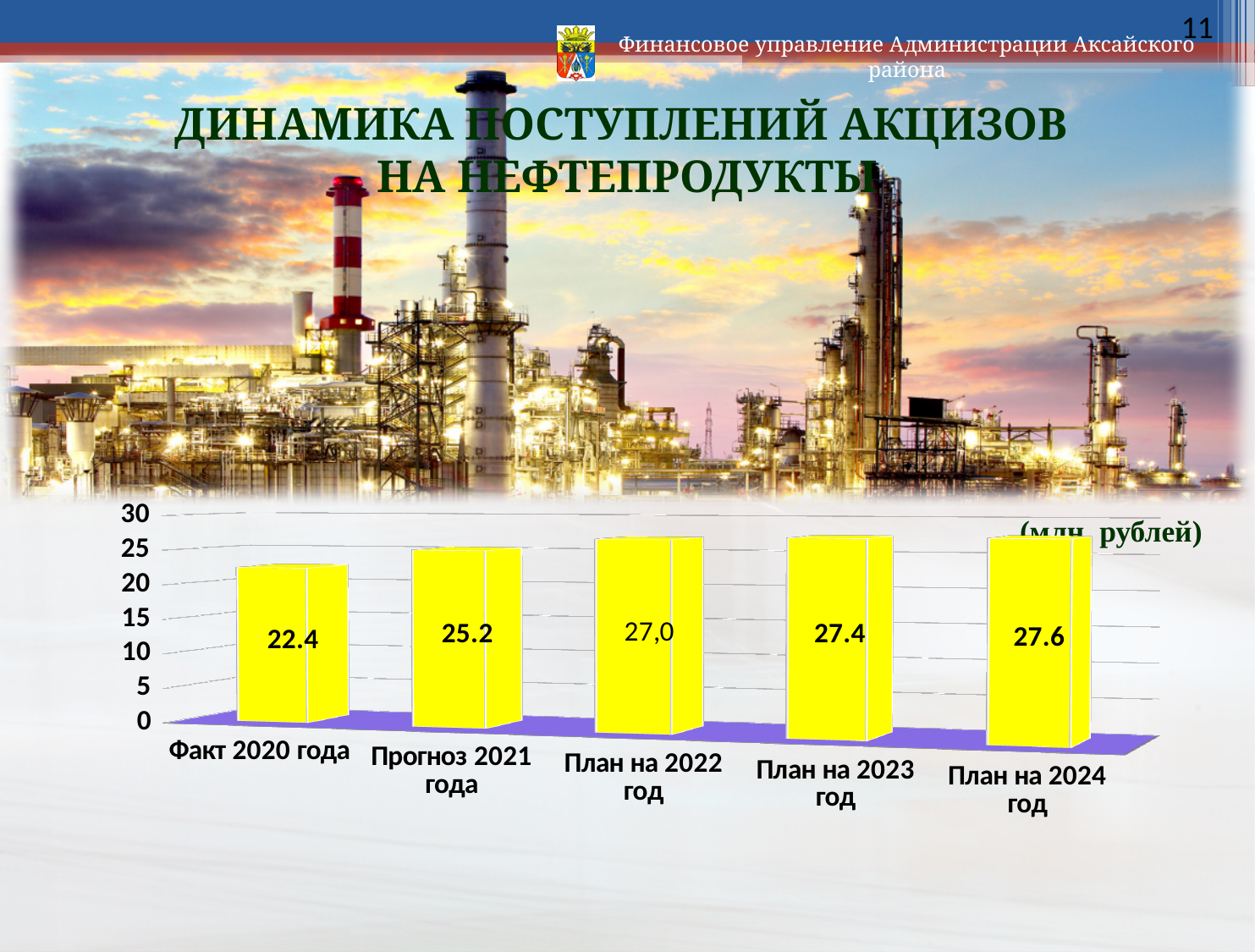
What kind of chart is shown on the slide? bar chart What is the difference between the values for План на 2024 год and Факт 2020 года? 5.2 Which category has the lowest value? Факт 2020 года How many categories are shown on the chart? 5 Do the values rise or fall from Факт 2020 года to План на 2024 год? rise Is the value for Факт 2020 года greater or less than 25? less What is the value for Факт 2020 года? 22.4 Which is larger, the value for План на 2023 год or the value for План на 2024 год? План на 2024 год What is the value for План на 2024 год? 27.6 Which category has the highest value? План на 2024 год What is the value for Прогноз 2021 года? 25.2 What is the difference between the values for Прогноз 2021 года and Факт 2020 года? 2.8